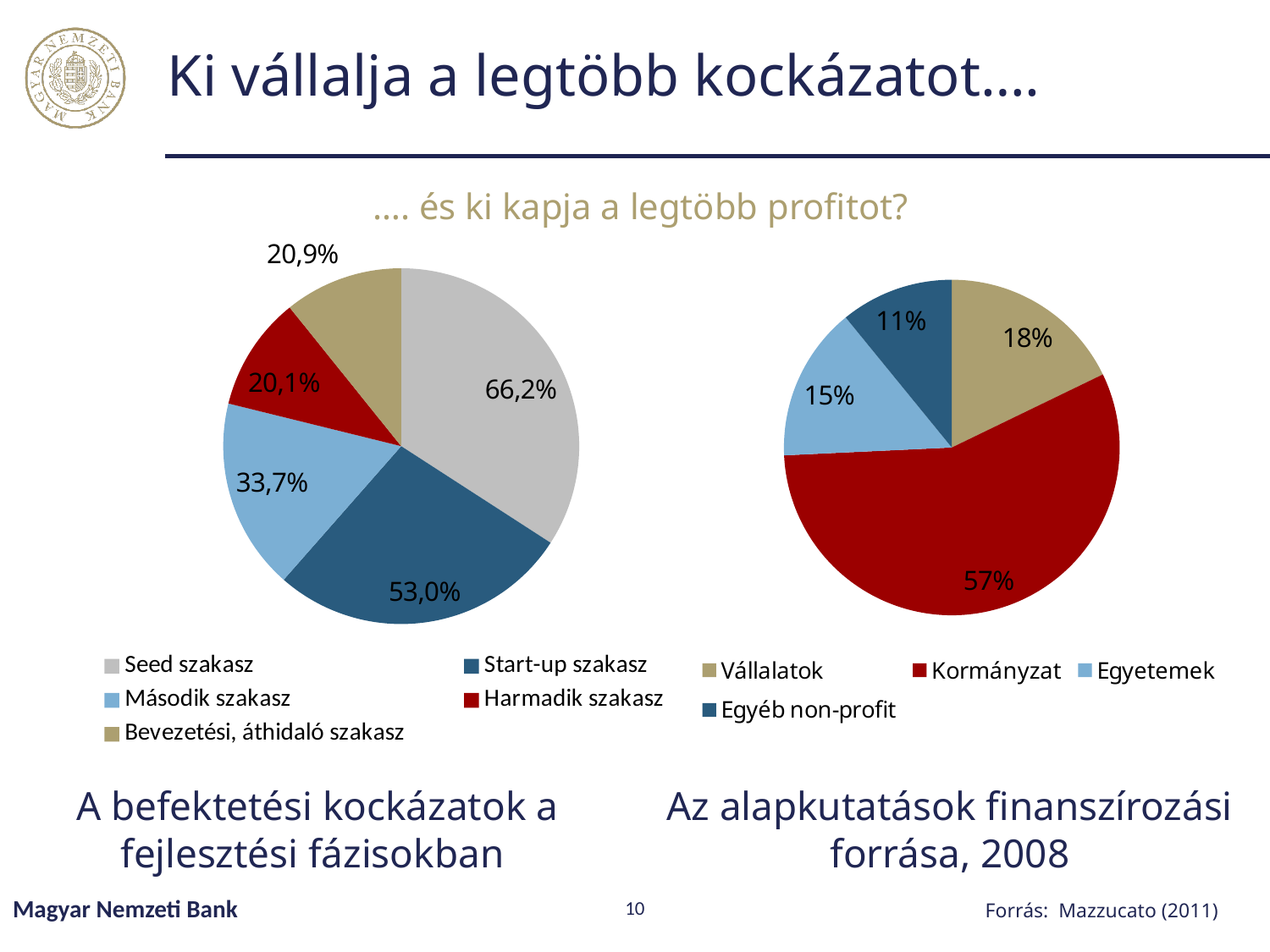
What kind of chart is used for Az alapkutatások finanszírozási forrása, 2008? Pie chart In the left chart (A befektetési kockázatok a fejlesztési fázisokban), how many categories does the legend list? 5 In the left chart (A befektetési kockázatok a fejlesztési fázisokban), what is the difference between the values for Seed szakasz and Start-up szakasz? 13,2 percentage points In the left chart (A befektetési kockázatok a fejlesztési fázisokban), which category has the largest slice? Seed szakasz In the right chart (Az alapkutatások finanszírozási forrása, 2008), what value is shown for Egyetemek? 15% In the right chart (Az alapkutatások finanszírozási forrása, 2008), which category has the smallest slice? Egyéb non-profit In the left chart (A befektetési kockázatok a fejlesztési fázisokban), what value is shown for Második szakasz? 33,7% In the left chart (A befektetési kockázatok a fejlesztési fázisokban), which is larger: Start-up szakasz or Második szakasz? Start-up szakasz In the right chart (Az alapkutatások finanszírozási forrása, 2008), what share is shown for Kormányzat? 57% In the left chart (A befektetési kockázatok a fejlesztési fázisokban), what value is shown for Seed szakasz? 66,2% In the right chart (Az alapkutatások finanszírozási forrása, 2008), what is the difference between the values for Kormányzat and Vállalatok? 39 percentage points In the right chart (Az alapkutatások finanszírozási forrása, 2008), what colour is the Kormányzat slice? Red